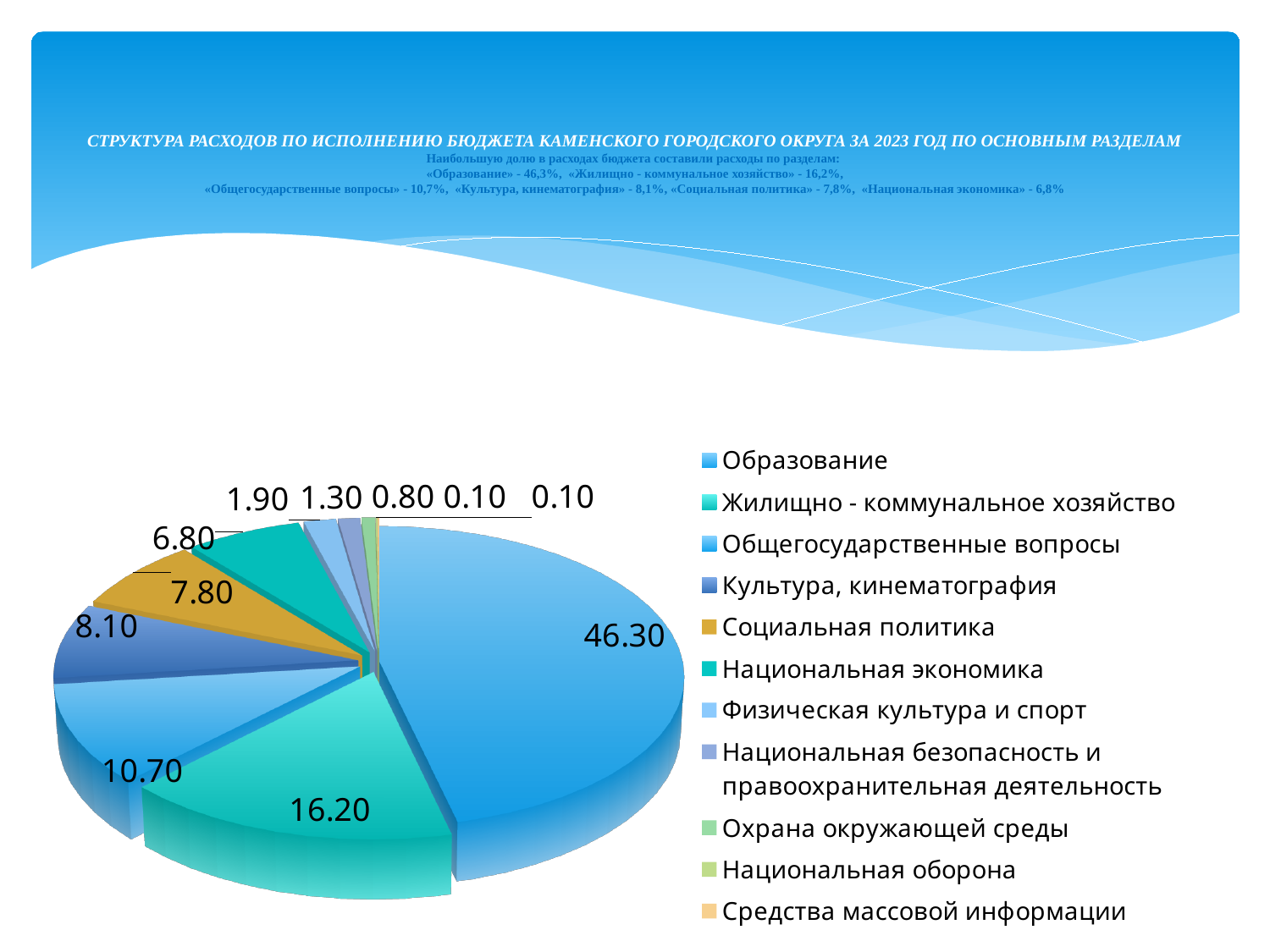
What is the difference between the Общегосударственные вопросы value and the Культура, кинематография value? 2.60 How many entries does the legend of the pie chart list? 11 What is the difference between the Образование value and the Жилищно - коммунальное хозяйство value? 30.10 What value is shown for the Образование slice? 46.30 What value is shown for the Национальная экономика slice? 6.80 What value is shown for the Социальная политика slice? 7.80 Which is larger, the Культура, кинематография slice or the Социальная политика slice? Культура, кинематография What kind of chart is shown on the slide? pie chart What value is shown for the Общегосударственные вопросы slice? 10.70 Which category has the largest slice of the pie? Образование What value is shown for the Жилищно - коммунальное хозяйство slice? 16.20 What colour is the Социальная политика slice in the pie chart? gold/yellow